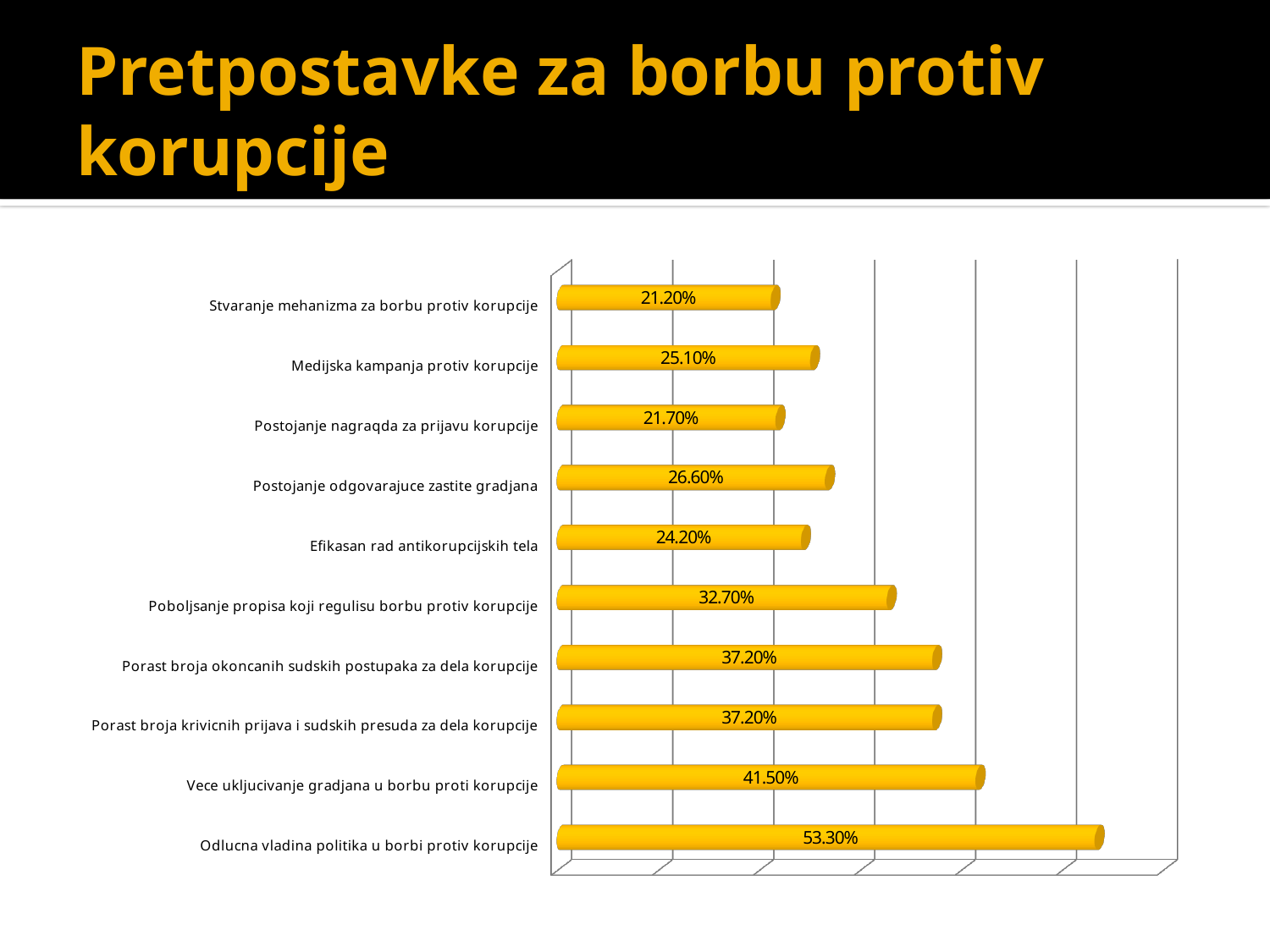
What is the value for "Efikasan rad antikorupcijskih tela"? 24.20% Which category has the highest value? Odlucna vladina politika u borbi protiv korupcije What is the value for "Poboljsanje propisa koji regulisu borbu protiv korupcije"? 32.70% What is the value for "Medijska kampanja protiv korupcije"? 25.10% Which category has the lowest value? Stvaranje mehanizma za borbu protiv korupcije What is the title of the slide? Pretpostavke za borbu protiv korupcije What kind of chart is shown on the slide? Bar chart What is the value for "Odlucna vladina politika u borbi protiv korupcije"? 53.30% Which is larger, the value for "Postojanje odgovarajuce zastite gradjana" or the value for "Postojanje nagraqda za prijavu korupcije"? Postojanje odgovarajuce zastite gradjana What is the difference between the values for "Porast broja okoncanih sudskih postupaka za dela korupcije" and "Poboljsanje propisa koji regulisu borbu protiv korupcije"? 4.50% What is the difference between the values for "Odlucna vladina politika u borbi protiv korupcije" and "Vece ukljucivanje gradjana u borbu proti korupcije"? 11.80% How many categories are shown in the chart? 10